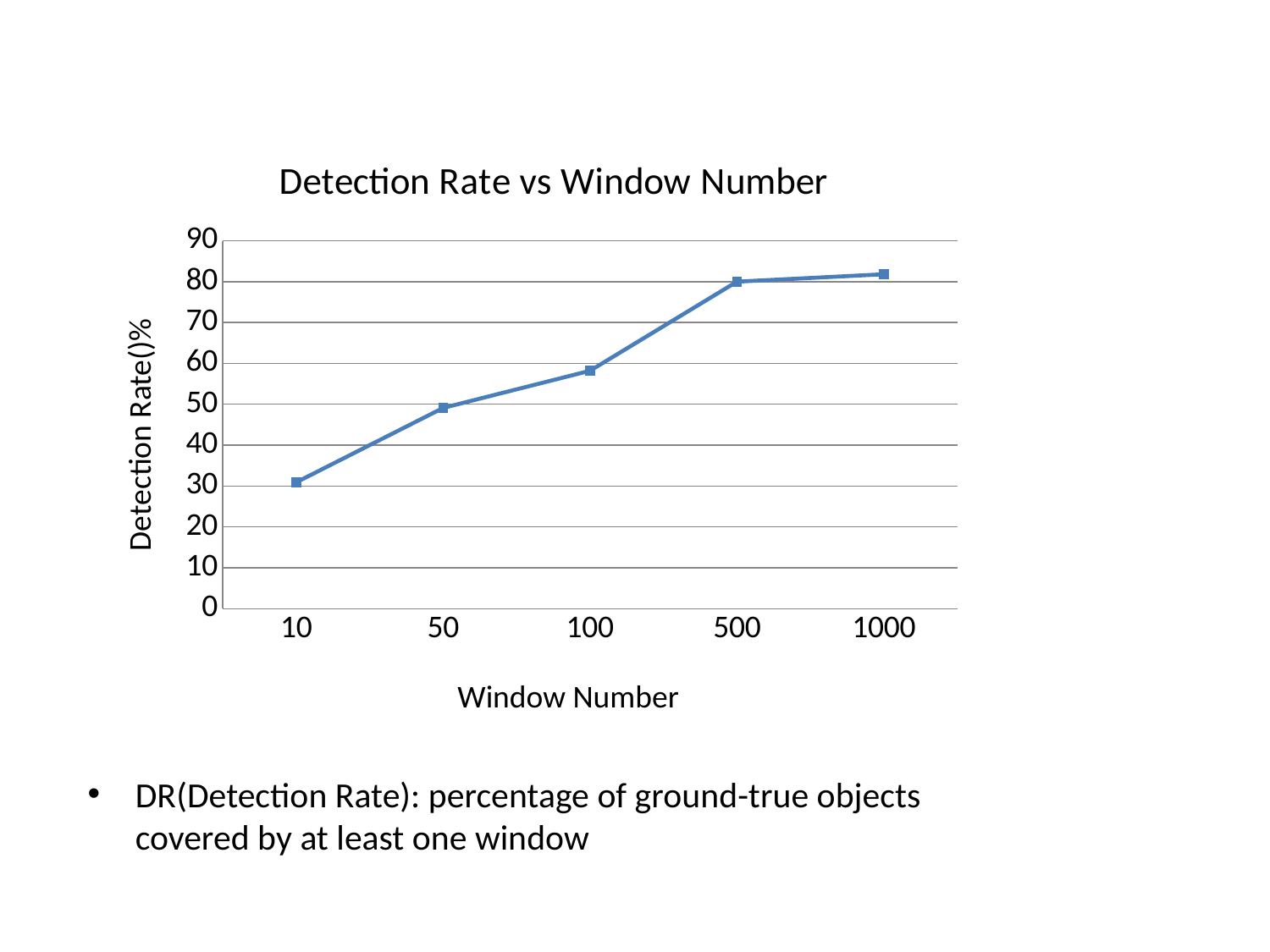
Is the detection rate for window number 50 greater or less than 40? greater How many data points are plotted on the line? 5 Which has the higher detection rate, window number 100 or window number 500? 500 What is the label of the x axis? Window Number Which window number has the lowest detection rate? 10 Is the detection rate for window number 100 greater or less than 50? greater Which has the higher detection rate, window number 10 or window number 50? 50 What kind of chart is shown on the slide? line chart Is the detection rate for window number 1000 greater or less than 70? greater Does the detection rate rise or fall as the window number increases along the x axis? rise What is the title of the chart? Detection Rate vs Window Number